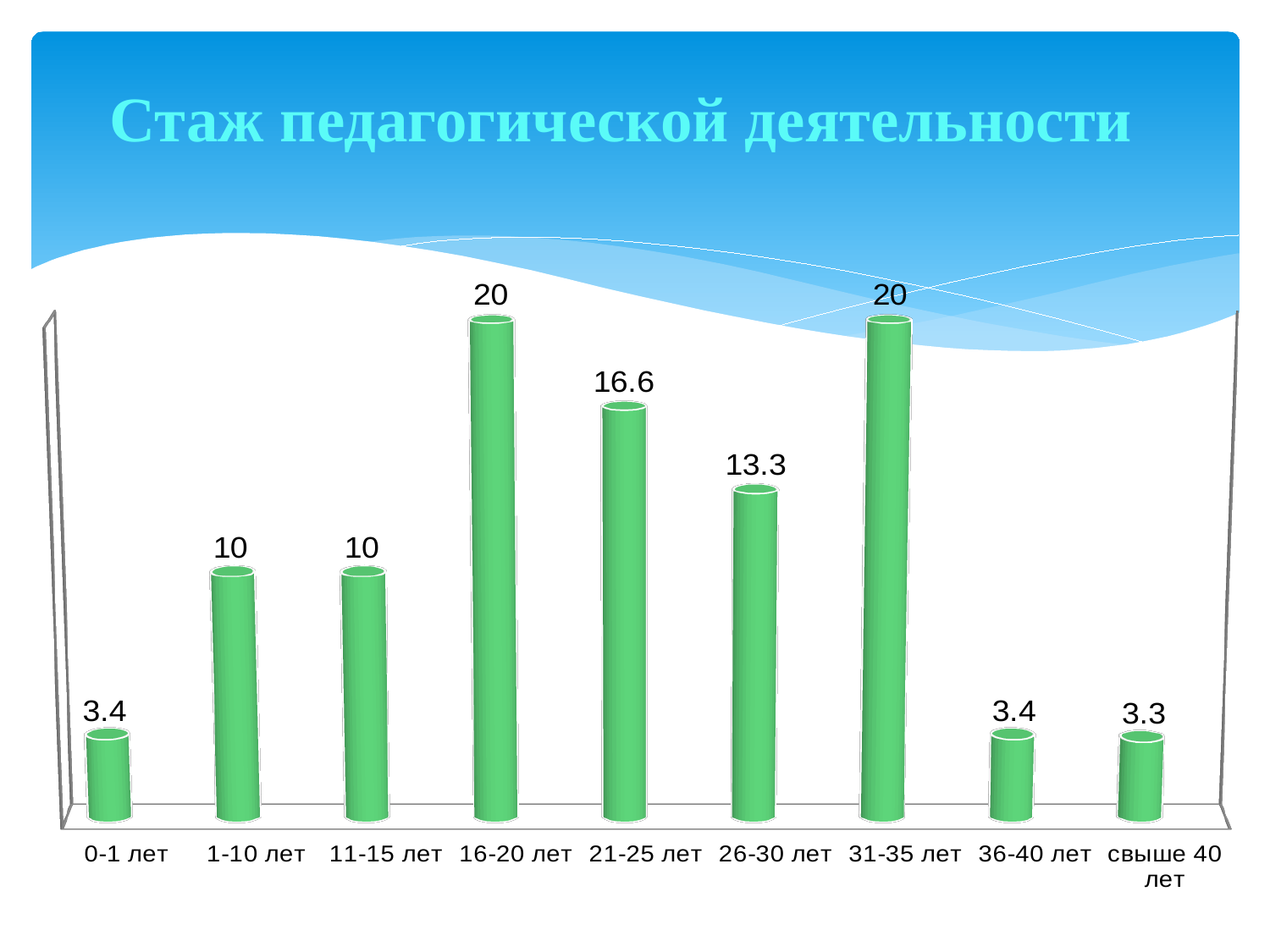
Which category has the lowest value? свыше 40 лет What is the difference between the values for 21-25 лет and 1-10 лет? 6.6 What is the value for the 26-30 лет category? 13.3 Which categories have the highest value? 16-20 лет and 31-35 лет What is the difference between the values for 16-20 лет and 26-30 лет? 6.7 How many categories are shown on the x axis? 9 Which is larger, the value for 21-25 лет or the value for 26-30 лет? 21-25 лет What is the title of the chart? Стаж педагогической деятельности What is the value for the 21-25 лет category? 16.6 What is the value for the свыше 40 лет category? 3.3 What colour are the bars in the chart? green What kind of chart is shown on the slide? bar chart